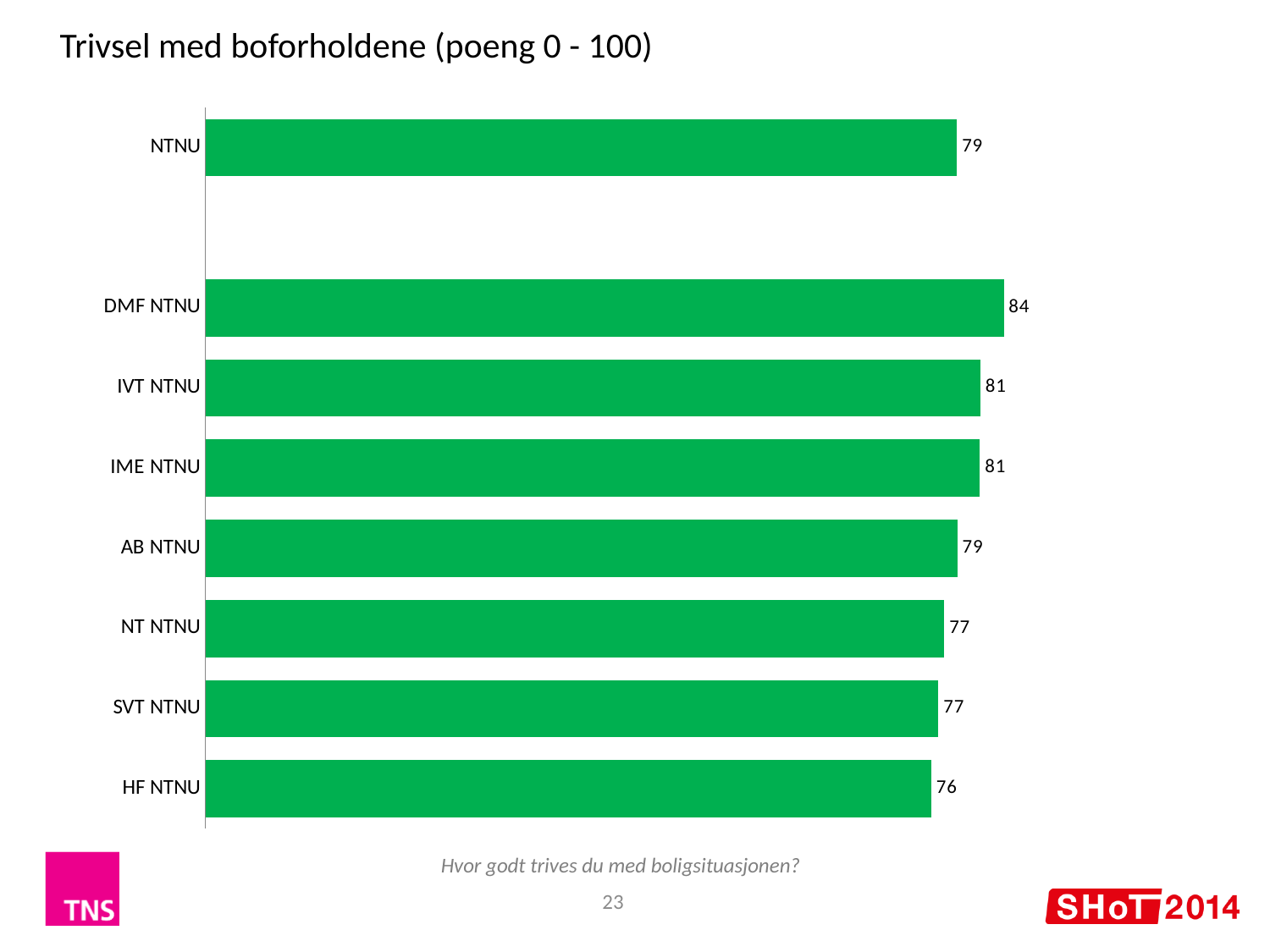
What is the title of the chart? Trivsel med boforholdene (poeng 0 - 100) Which is larger, the value for IME NTNU or the value for SVT NTNU? IME NTNU Which category has the lowest value? HF NTNU What is the difference between the values for DMF NTNU and HF NTNU? 8 Which category has the highest value? DMF NTNU What is the value for HF NTNU? 76 How many categories are shown in the chart? 8 What is the value for DMF NTNU? 84 What is the value for NT NTNU? 77 What is the value for NTNU? 79 What is the difference between the values for IVT NTNU and AB NTNU? 2 What kind of chart is shown on the slide? Bar chart